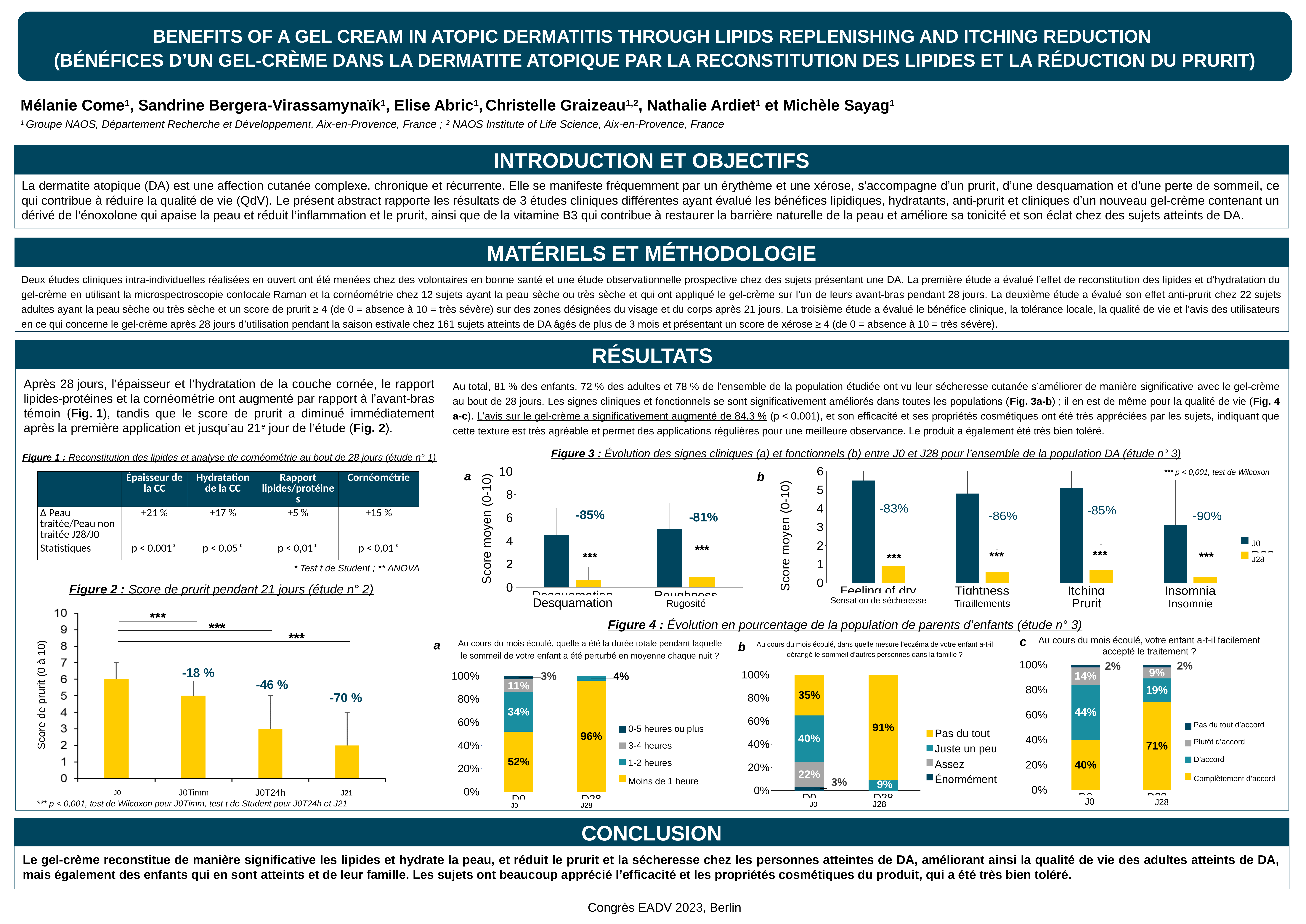
In Figure 3b, how many series does the legend list? 2 In Figure 2 (Score de prurit pendant 21 jours), do the pruritus scores rise or fall from J0 to J21? fall In Figure 4a, what percentage of the J28 bar corresponds to 'Moins de 1 heure'? 96% In Figure 2 (Score de prurit pendant 21 jours), is the pruritus score for J0 greater or less than 5? greater In Figure 4b, what is the difference between the 'Pas du tout' share at J28 (91%) and at J0 (35%)? 56% In Figure 3b, is the J0 score for Tiraillements (Tightness) greater or less than 4? greater In Figure 3a, what percentage reduction is labelled for Rugosité (Roughness)? -81% In Figure 3b, what percentage reduction is labelled for Insomnie (Insomnia)? -90% In Figure 2 (Score de prurit pendant 21 jours), what percentage change is labelled above the J0Timm bar? -18 % In Figure 4c, which is larger: the 'Complètement d'accord' share at J0 or at J28? J28 In Figure 2 (Score de prurit pendant 21 jours), how many categories are shown on the x axis? 4 In Figure 2 (Score de prurit pendant 21 jours), what percentage change is labelled above the J21 bar? -70 %